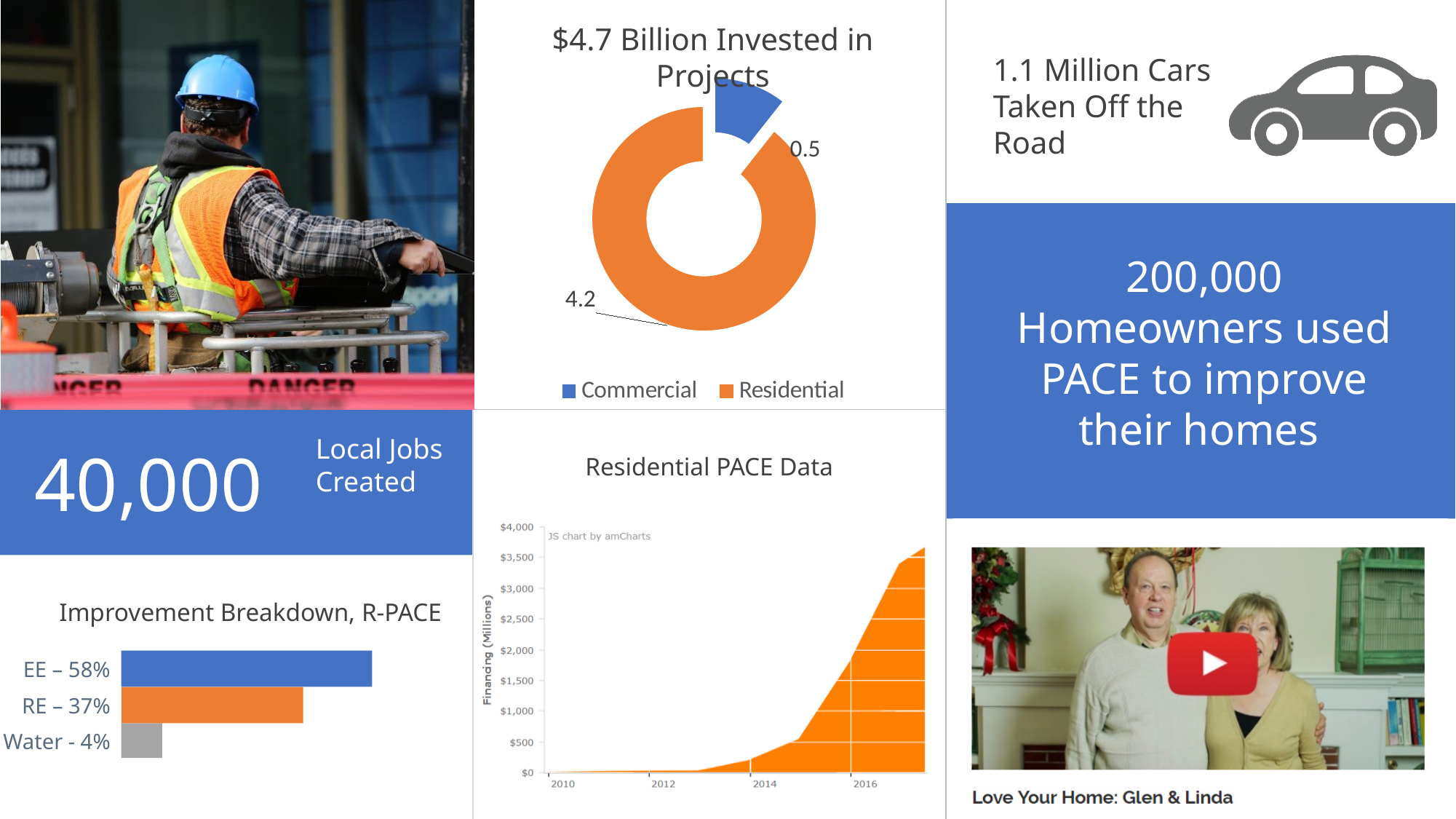
In the "Residential PACE Data" chart, is the financing value for 2016 greater or less than $1,000 million? greater In the "$4.7 Billion Invested in Projects" chart, which category has the larger value? Residential In the "$4.7 Billion Invested in Projects" chart, what is the value for Commercial? 0.5 In the "Residential PACE Data" chart, do the financing values rise or fall from 2010 to 2016? Rise What kind of chart is "$4.7 Billion Invested in Projects"? Doughnut chart In the "Improvement Breakdown, R-PACE" chart, which category has the lowest value? Water In the "$4.7 Billion Invested in Projects" chart, what is the difference between the Residential and Commercial values? 3.7 In the "Improvement Breakdown, R-PACE" chart, what is the difference between EE and RE? 21% In the "$4.7 Billion Invested in Projects" chart, what is the value for Residential? 4.2 How many categories are shown in the "Improvement Breakdown, R-PACE" chart? 3 In the "Improvement Breakdown, R-PACE" chart, what is the value for RE? 37% How many entries does the legend of the "$4.7 Billion Invested in Projects" chart list? 2